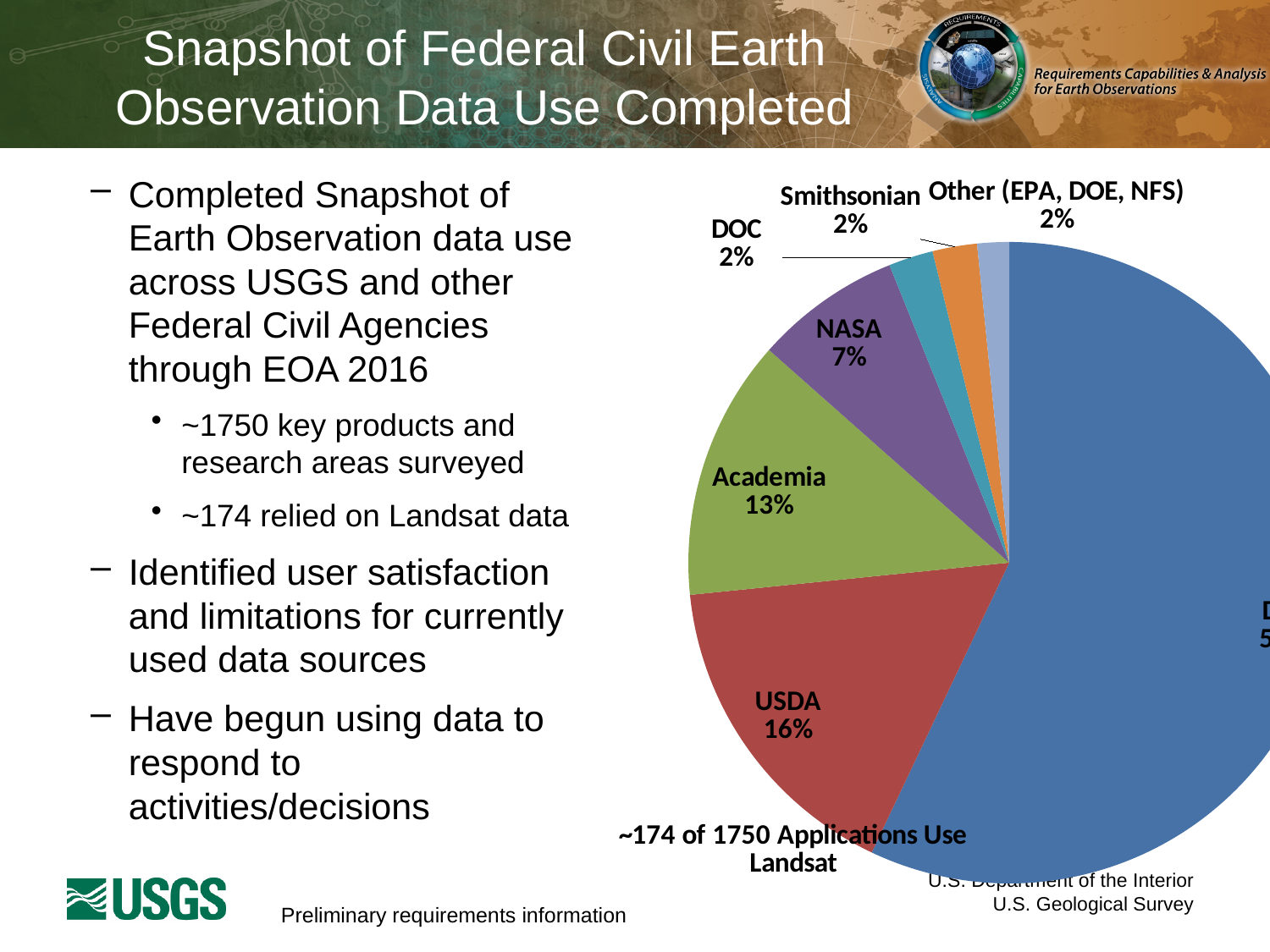
What share of the pie does DOC account for? 2% Which has the larger share, NASA or DOC? NASA How many percentage points larger is USDA's share than Academia's? 3 How many percentage points larger is Academia's share than NASA's? 6 What percentage is shown for Academia? 13% What kind of chart is shown on the slide? pie chart Which has the larger share, USDA or Academia? USDA What percentage is shown for Smithsonian? 2% What percentage is shown for Other (EPA, DOE, NFS)? 2% What share of the pie does USDA account for? 16% What percentage is shown for NASA? 7% What is the title of the pie chart? ~174 of 1750 Applications Use Landsat